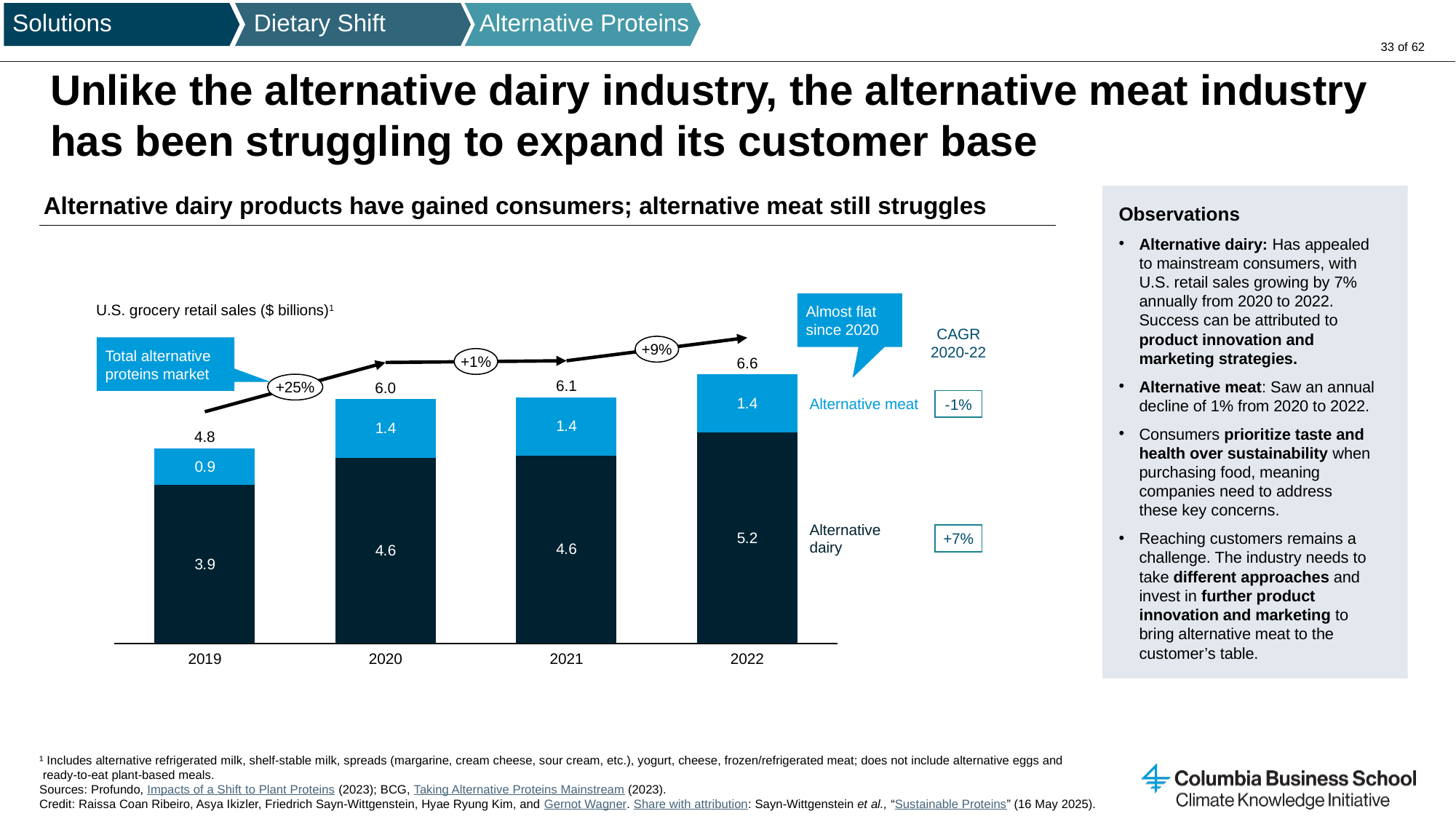
What was U.S. grocery retail sales of alternative dairy in 2019? 3.9 How many years are shown on the x axis of the chart? 4 Do the total alternative proteins market values rise or fall from 2019 to 2022? Rise Which year has the lowest alternative meat sales? 2019 What is the total alternative proteins market value shown for 2021? 6.1 What is the difference between alternative dairy sales in 2022 and 2019? 1.3 Which year has the highest total alternative proteins market value? 2022 What type of chart is shown on the slide? Stacked bar chart Which is larger: alternative dairy sales in 2020 or alternative dairy sales in 2022? 2022 What CAGR for 2020-22 is shown for alternative meat? -1% What was U.S. grocery retail sales of alternative meat in 2022? 1.4 How many series are stacked in each bar of the chart? 2